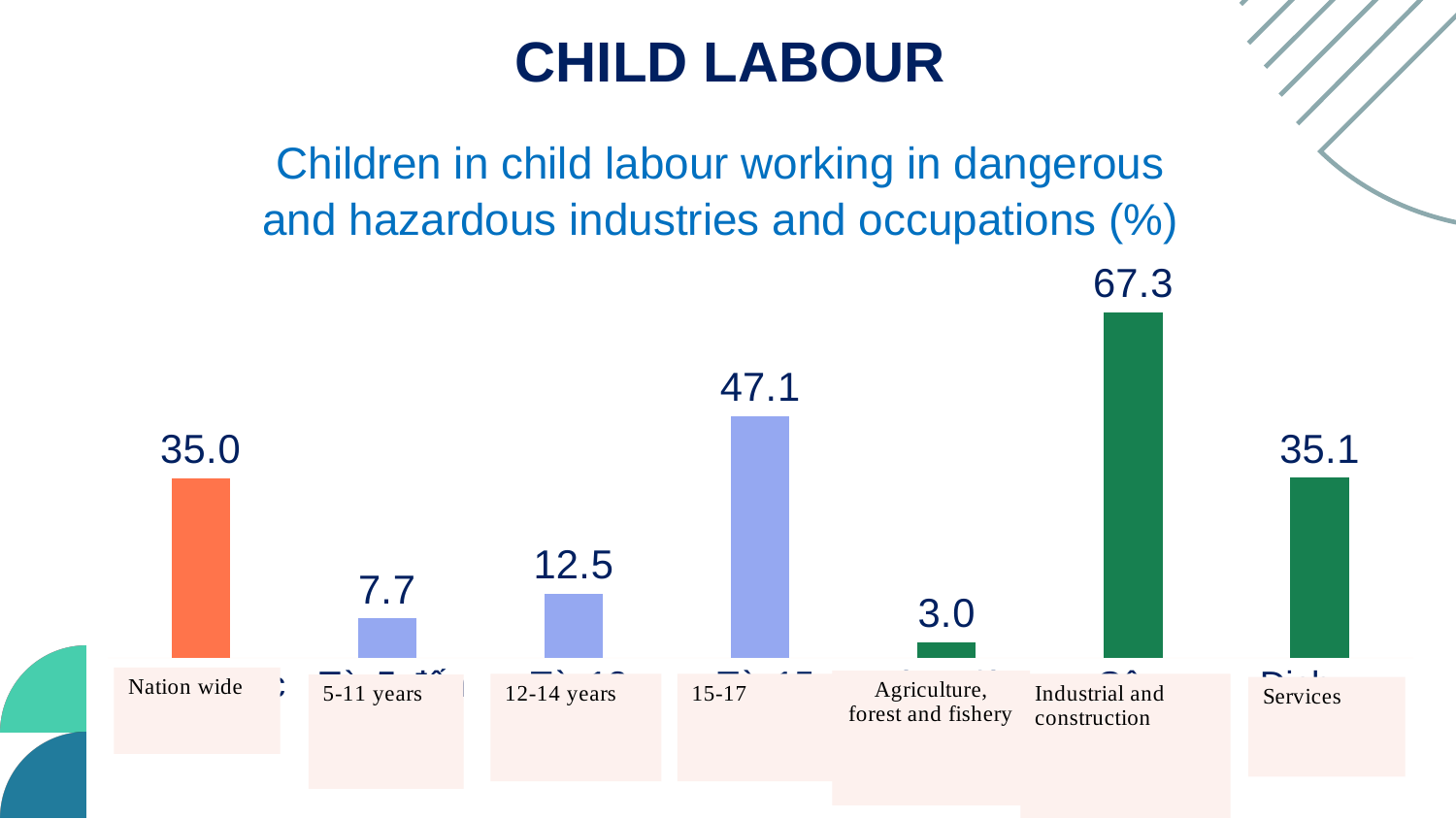
What type of chart is shown on the slide? Bar chart Which is larger, the value for 5-11 years or for 12-14 years? 12-14 years What is the Nation wide value? 35.0 What is the difference between the values for 15-17 and 12-14 years? 34.6 What is the value for Industrial and construction? 67.3 What is the value for Agriculture, forest and fishery? 3.0 What is the value for the 15-17 age group? 47.1 Do the values rise or fall across the three age groups from 5-11 years to 15-17? Rise Which category has the highest value? Industrial and construction How many bars are shown in the chart? 7 What is the difference between Industrial and construction and Services? 32.2 Which category has the lowest value? Agriculture, forest and fishery